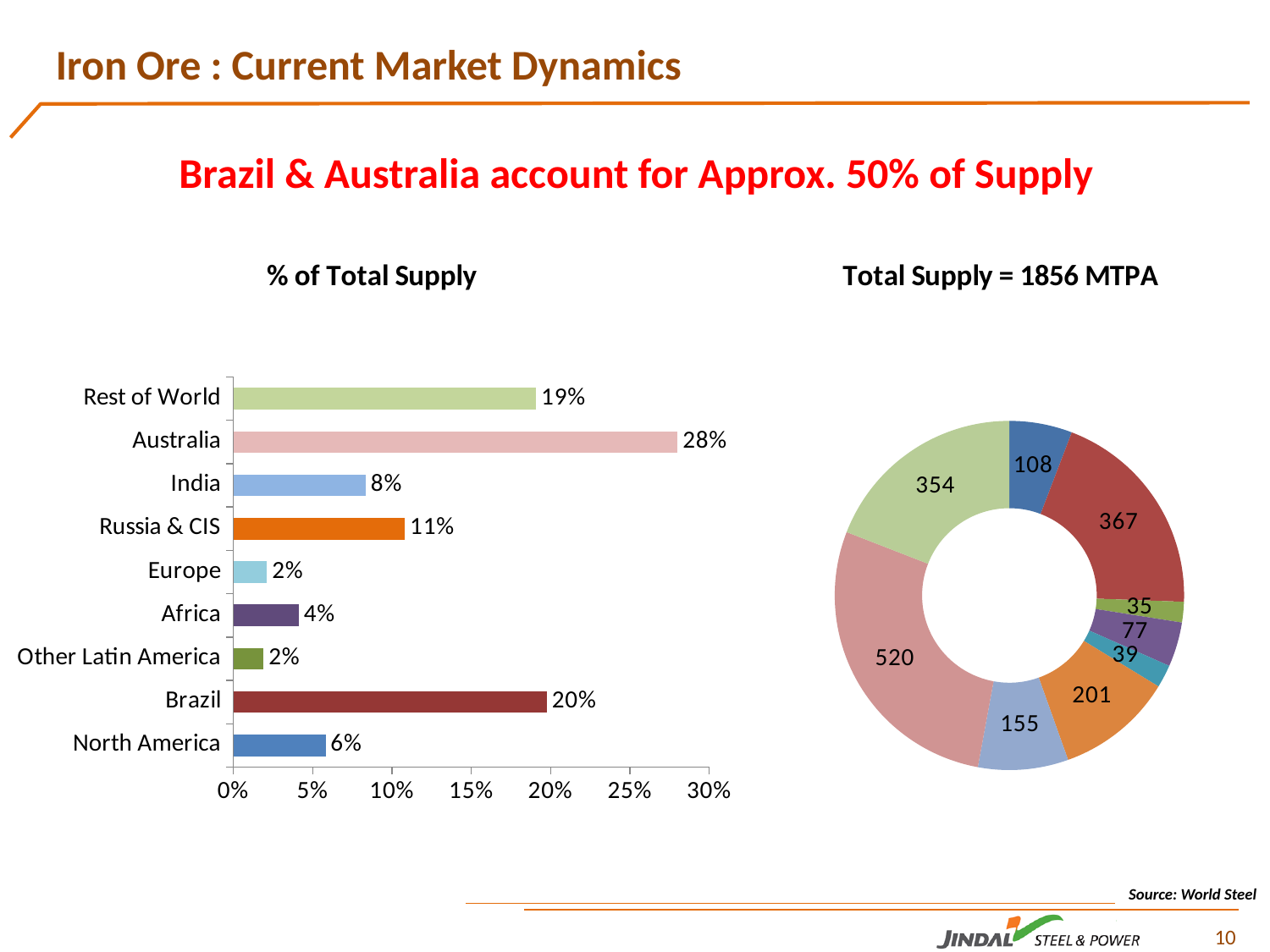
What kind of chart is the '% of Total Supply' chart on the left? Bar chart How many categories are shown in the '% of Total Supply' bar chart? 9 In the '% of Total Supply' bar chart, what is the value for Australia? 28% In the 'Total Supply = 1856 MTPA' chart on the right, what is the value of the smallest segment? 35 In the '% of Total Supply' bar chart, what is the difference between the values for Australia and Brazil? 8% What kind of chart is the 'Total Supply = 1856 MTPA' chart on the right? Doughnut chart How many segments are shown in the 'Total Supply = 1856 MTPA' chart on the right? 9 In the '% of Total Supply' bar chart, which is larger, the value for India or the value for Russia & CIS? Russia & CIS In the 'Total Supply = 1856 MTPA' chart on the right, what is the value of the largest segment? 520 In the '% of Total Supply' bar chart, what is the value for Russia & CIS? 11% In the '% of Total Supply' bar chart, which category has the highest value? Australia In the '% of Total Supply' bar chart, what is the value for Brazil? 20%